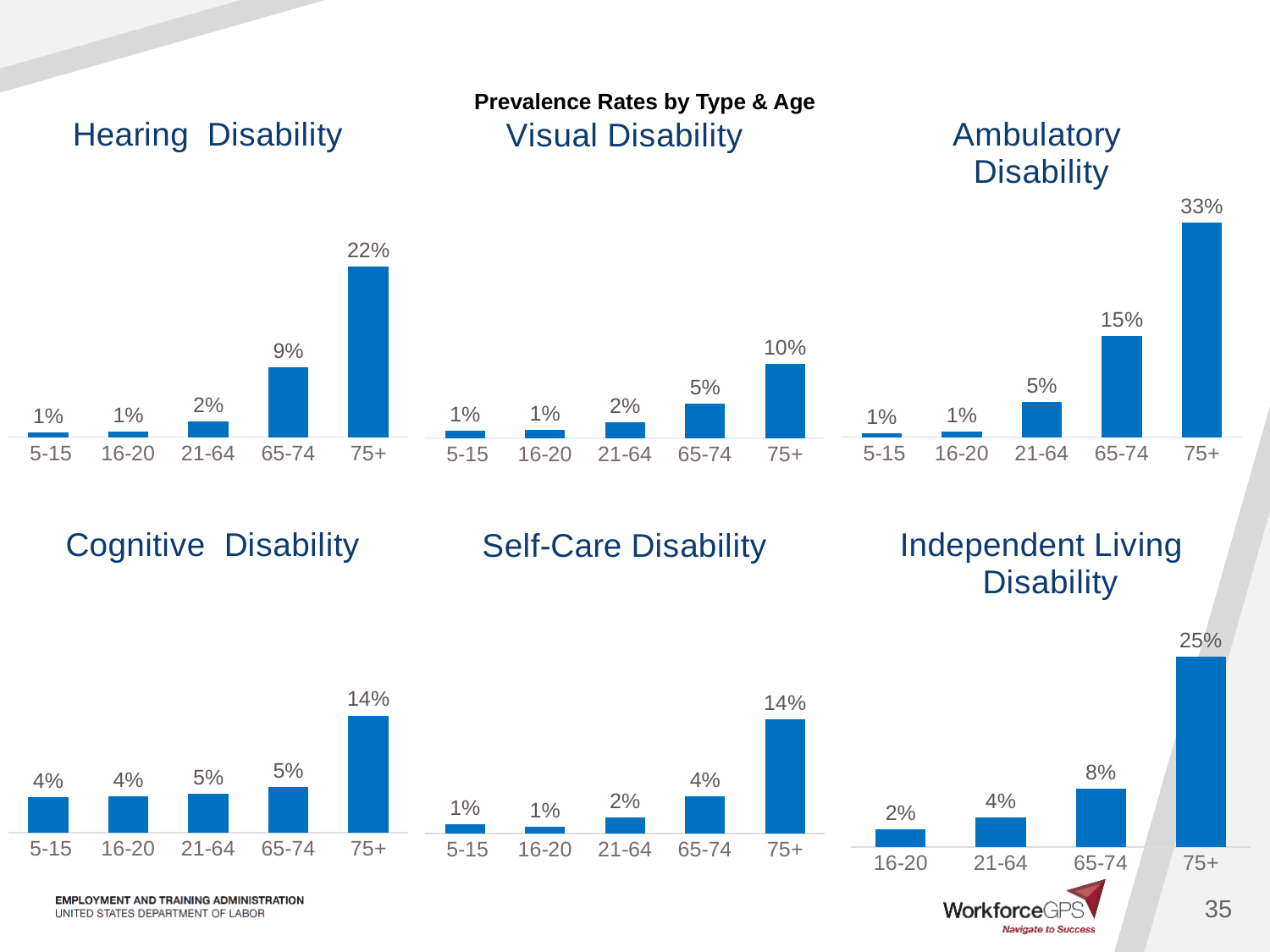
How many charts are shown on the slide? 6 In the Hearing Disability chart, what is the value for the 75+ age group? 22% In the Visual Disability chart, do the values rise or fall from the 5-15 group to the 75+ group? Rise What kind of chart is the Hearing Disability chart? Bar chart In the Visual Disability chart, what is the value for the 65-74 age group? 5% In the Self-Care Disability chart, which is larger, the value for 65-74 or the value for 21-64? 65-74 How many age groups are shown in the Independent Living Disability chart? 4 In the Ambulatory Disability chart, what is the difference between the 75+ and 65-74 values? 18% In the Independent Living Disability chart, what is the value for the 16-20 age group? 2% In the Ambulatory Disability chart, which age group has the highest value? 75+ In the Hearing Disability chart, what is the difference between the 75+ and 65-74 values? 13% In the Cognitive Disability chart, what is the value for the 5-15 age group? 4%